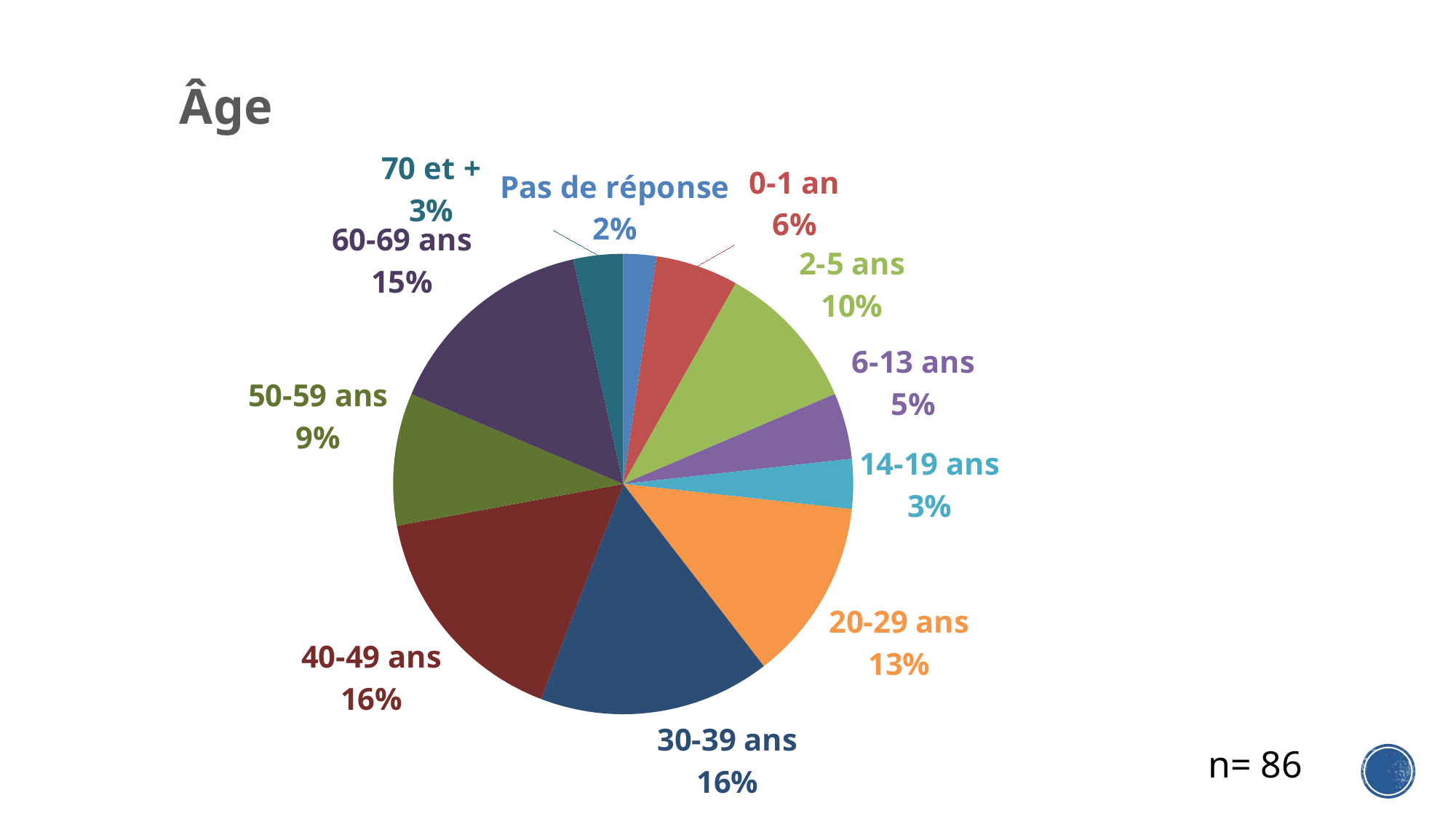
What is the difference between the values for 60-69 ans and 70 et +? 12% What is the title of the chart? Âge How many categories are shown in the pie chart? 11 What share of the pie does the 20-29 ans slice represent? 13% Which is larger, the value for 0-1 an or the value for 14-19 ans? 0-1 an What is the value shown for 2-5 ans? 10% Which category has the smallest slice of the pie? Pas de réponse What sample size (n) is indicated on the slide? 86 What is the value shown for 6-13 ans? 5% What kind of chart is shown on the slide? pie chart What is the value shown for 60-69 ans? 15% What is the difference between the values for 40-49 ans and 50-59 ans? 7%